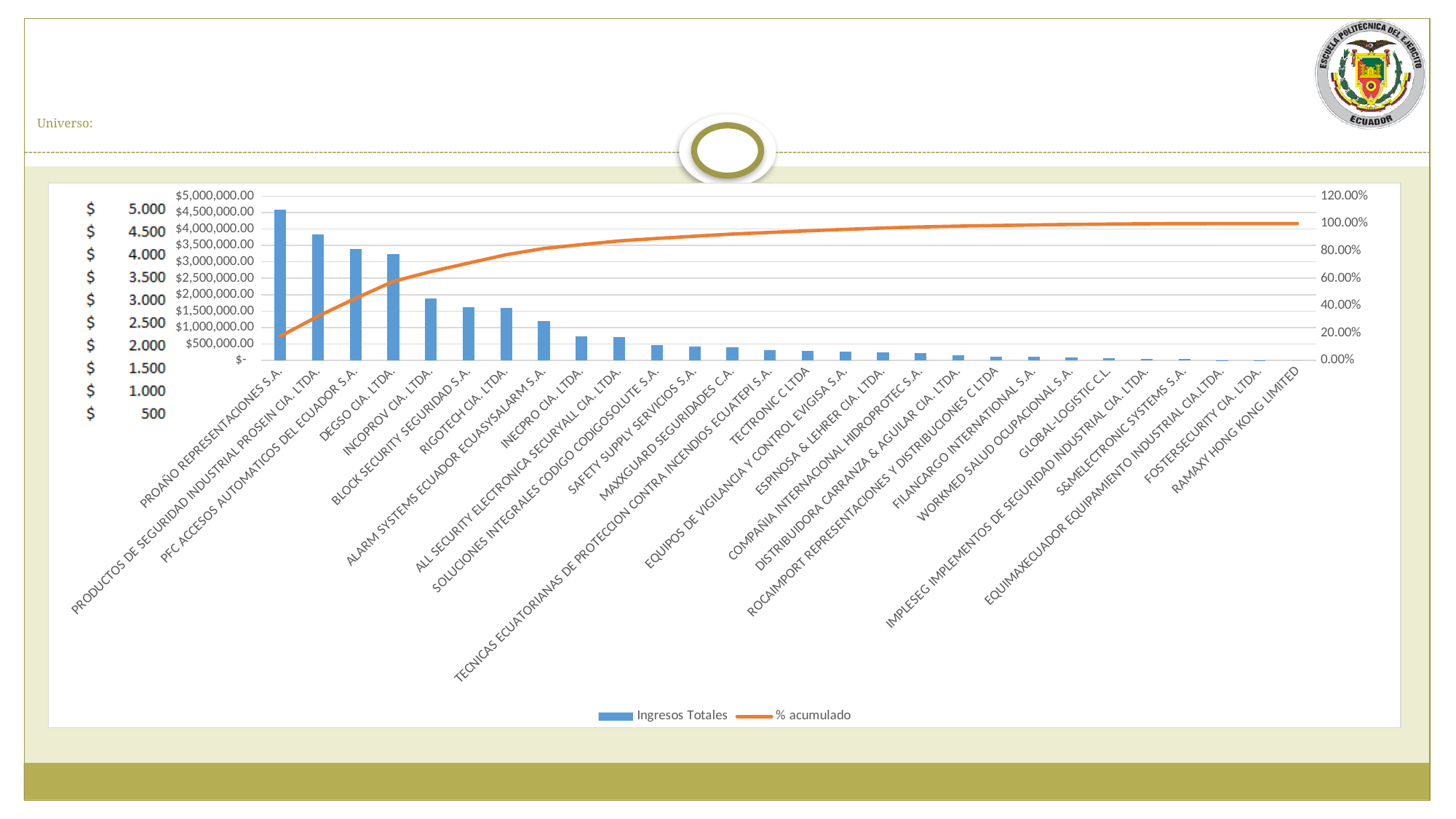
How many series does the legend list? 2 How many companies (categories) are plotted on the x axis? 28 What kind of chart is shown on the slide? A combination chart with bars and a line What are the two series named in the legend? Ingresos Totales and % acumulado Is the Ingresos Totales value for INECPRO CIA. LTDA. greater or less than $1,000,000.00? less Which has a larger Ingresos Totales bar, INCOPROV CIA. LTDA. or RIGOTECH CIA. LTDA.? INCOPROV CIA. LTDA. Is the Ingresos Totales value for BLOCK SECURITY SEGURIDAD S.A. greater or less than $1,000,000.00? greater Which has a larger Ingresos Totales bar, PROAÑO REPRESENTACIONES S.A. or PRODUCTOS DE SEGURIDAD INDUSTRIAL PROSEIN CIA. LTDA.? PROAÑO REPRESENTACIONES S.A. Is the Ingresos Totales value for PRODUCTOS DE SEGURIDAD INDUSTRIAL PROSEIN CIA. LTDA. greater or less than $4,000,000.00? less Which company has the highest Ingresos Totales bar? PROAÑO REPRESENTACIONES S.A. Do the Ingresos Totales bars rise or fall from left to right along the x axis? fall